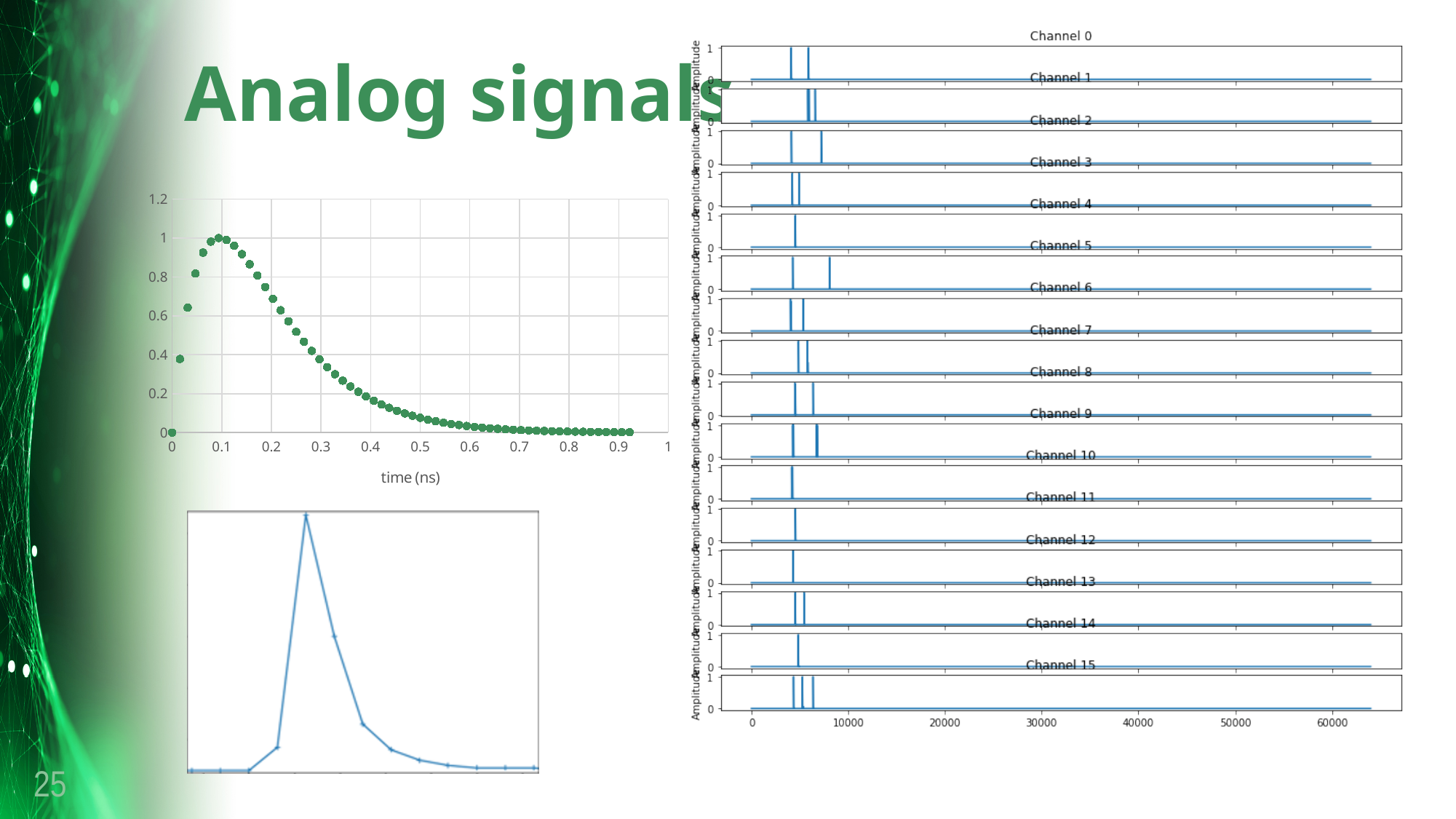
In the green scatter chart on the left, is the value at 0.2 ns greater or less than 0.4? greater How many channel panels are shown in the stacked chart on the right? 16 In the green scatter chart on the left, what is the label of the x axis? time (ns) In the stacked chart on the right, what is the largest tick value shown on the shared x axis? 60000 In the green scatter chart on the left, is the value at 0.5 ns greater or less than 0.2? less In the green scatter chart on the left, do the values rise or fall along the x axis after 0.1 ns? fall In the green scatter chart on the left, what is the highest value shown on the y axis? 1.2 What kind of chart is the green chart on the left with the x axis labelled time (ns)? scatter chart In the green scatter chart on the left, is the value at 0.3 ns greater or less than 0.2? greater What kind of chart is the blue chart at the bottom left of the slide? line chart In the stacked chart on the right, what is the title of the topmost panel? Channel 0